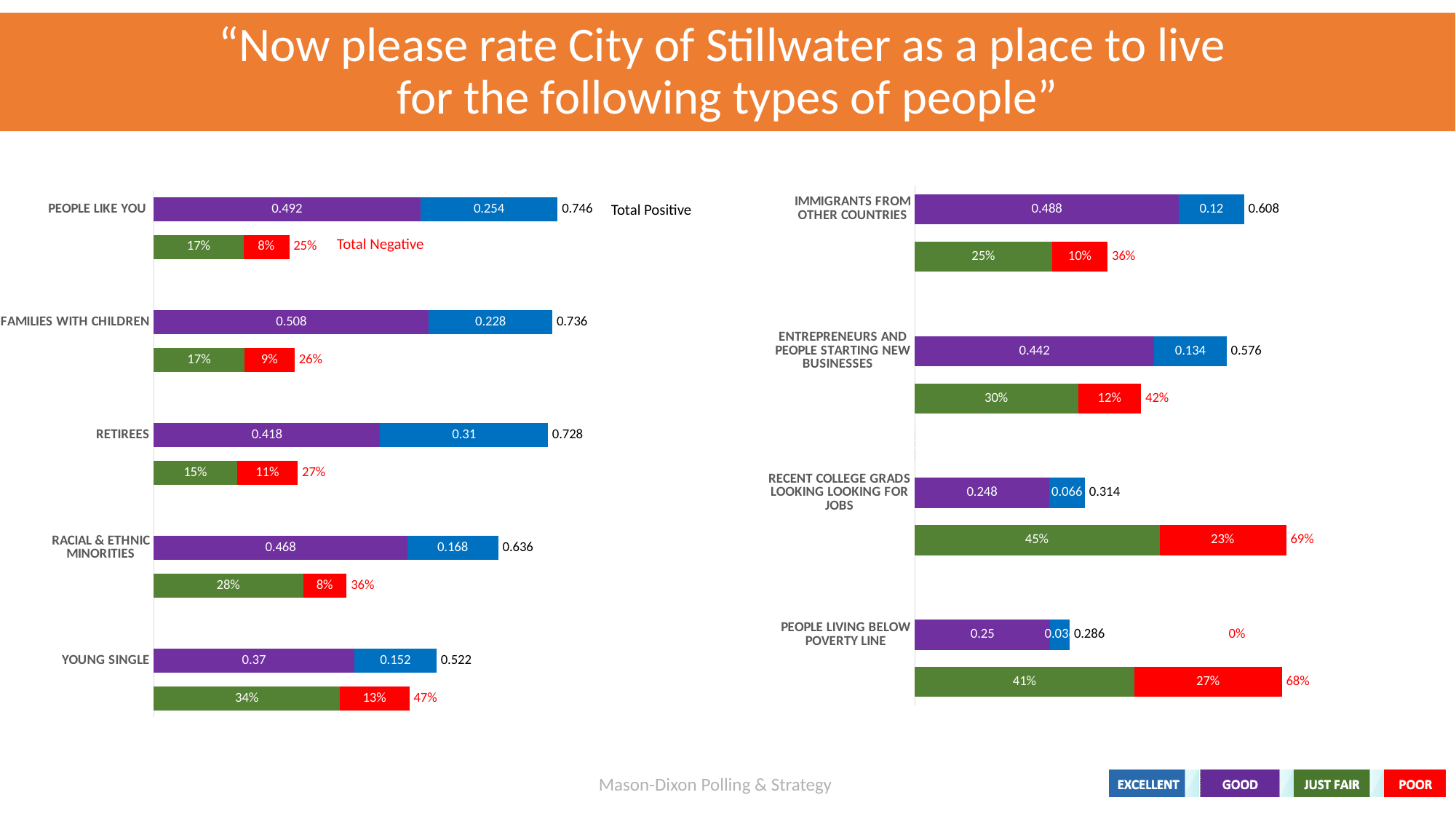
How many groups are shown on the left chart? 5 On the right chart, which group has the lowest Total Positive value? People Living Below Poverty Line What type of chart is used on the slide? Bar chart On the left chart, what is the Poor value for Racial & Ethnic Minorities? 8% On the left chart, what is the difference between the Total Negative values for Young Single and Retirees? 20% On the right chart, what is the Total Negative value for Recent College Grads Looking for Jobs? 69% On the right chart, which is larger: the Total Positive for Immigrants from Other Countries or for Entrepreneurs and People Starting New Businesses? Immigrants from Other Countries On the left chart, which group has the highest Total Positive value? People Like You On the left chart, what is the Total Positive value for People Like You? 0.746 How many rating categories does the legend at the bottom of the slide list? 4 On the right chart, what is the Excellent value for People Living Below Poverty Line? 0.03 On the left chart, what is the Good value for Families with Children? 0.508